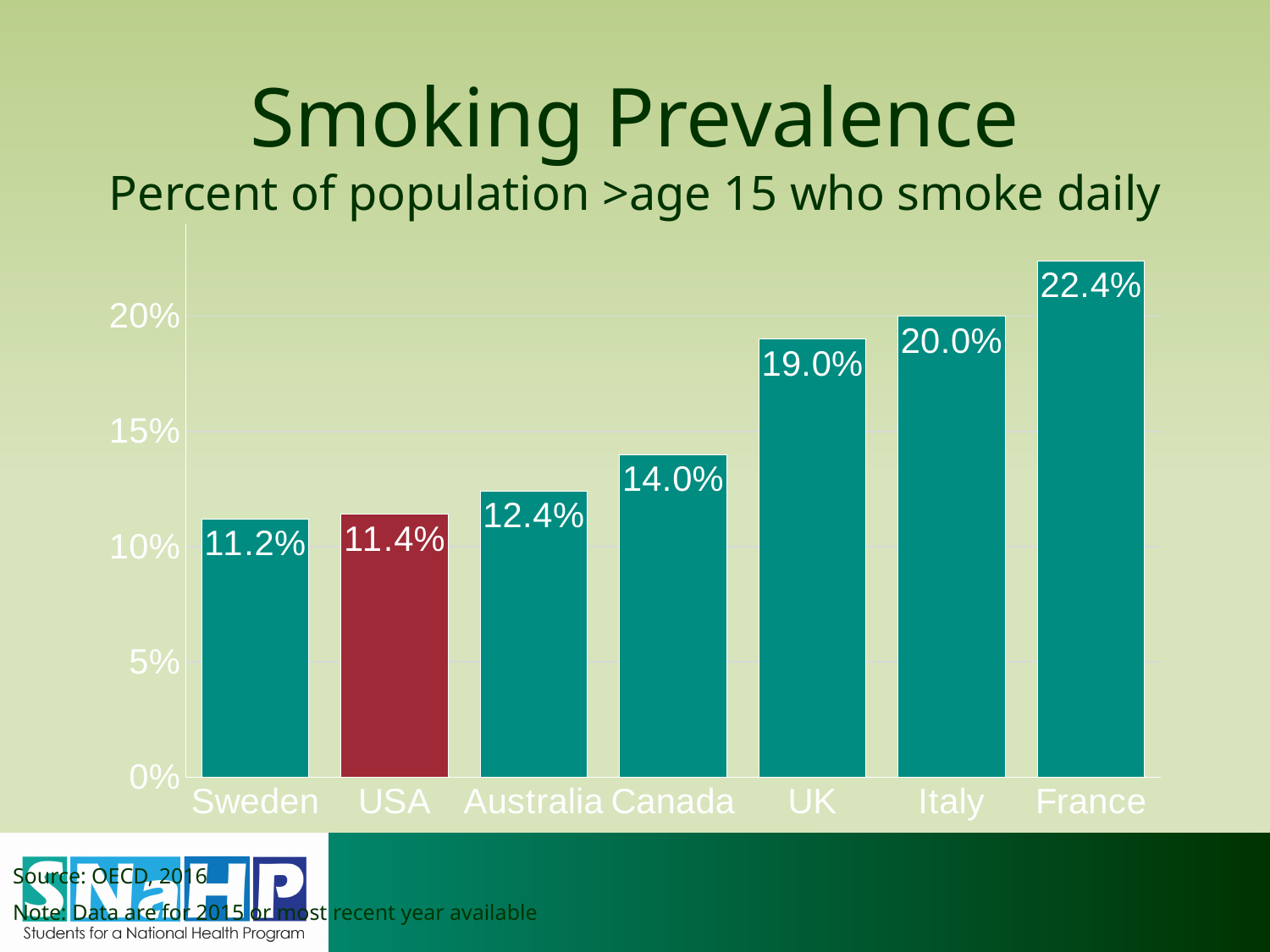
How many countries are shown on the chart? 7 What is the value shown for Canada? 14.0% What is the value shown for Italy? 20.0% Which country has the lowest smoking prevalence on the chart? Sweden Which has a higher value, Canada or Australia? Canada What kind of chart is shown on the slide? Bar chart What is the smoking prevalence value shown for the USA? 11.4% Which country has the highest smoking prevalence on the chart? France Which country's bar is coloured differently (red) from the others? USA What is the difference between the values for the UK and Australia? 6.6% Is the value for the UK greater or less than 15%? greater What is the difference between the values for France and Sweden? 11.2%